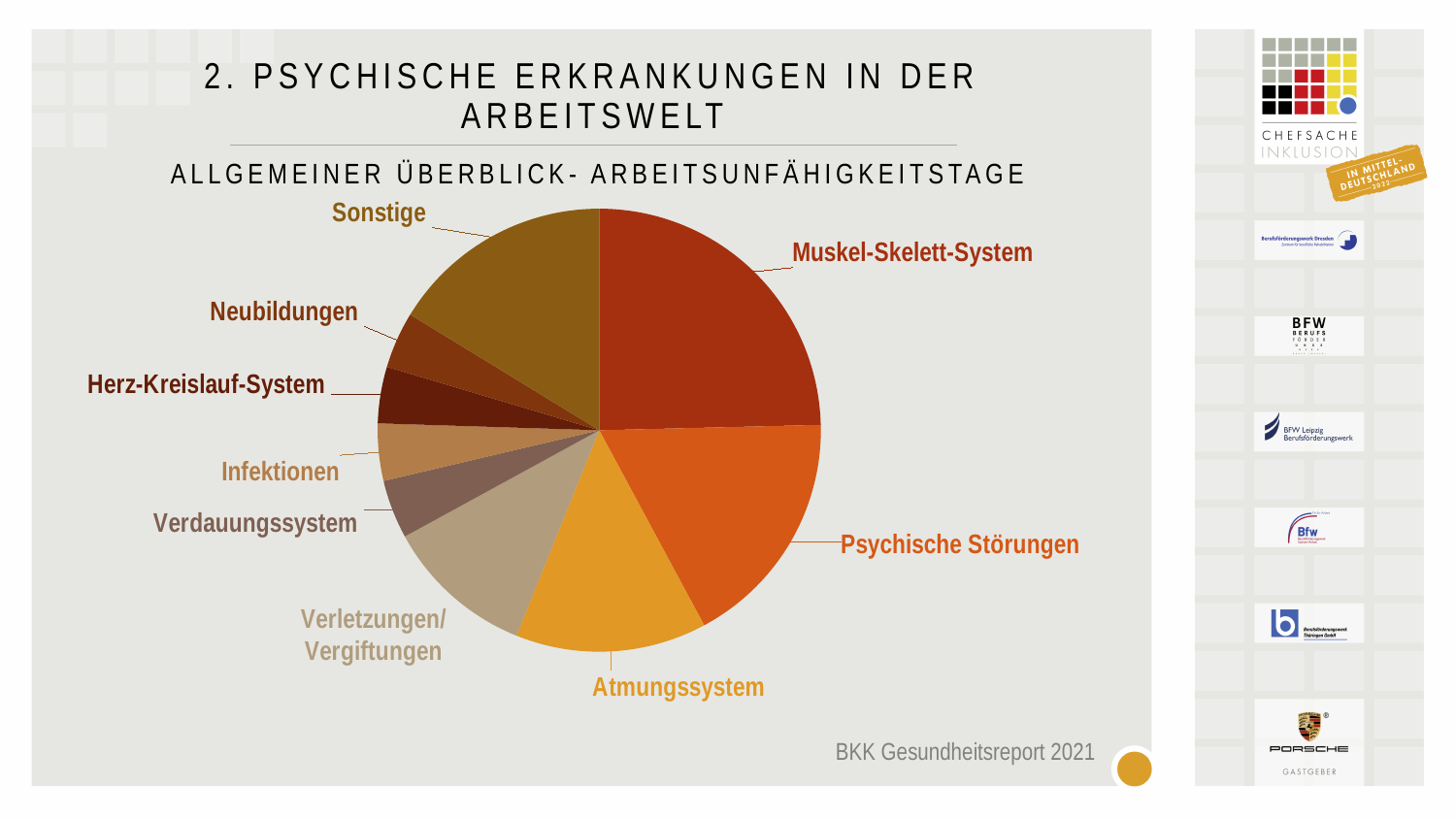
What source is cited below the pie chart? BKK Gesundheitsreport 2021 Which slice is larger, Muskel-Skelett-System or Psychische Störungen? Muskel-Skelett-System How many categories (slices) does the pie chart have? 9 What is the subtitle shown above the pie chart? Allgemeiner Überblick - Arbeitsunfähigkeitstage Which slice is larger, Atmungssystem or Herz-Kreislauf-System? Atmungssystem Which slice is larger, Sonstige or Infektionen? Sonstige Which category has the largest slice in the pie chart? Muskel-Skelett-System What kind of chart is shown on the slide? pie chart